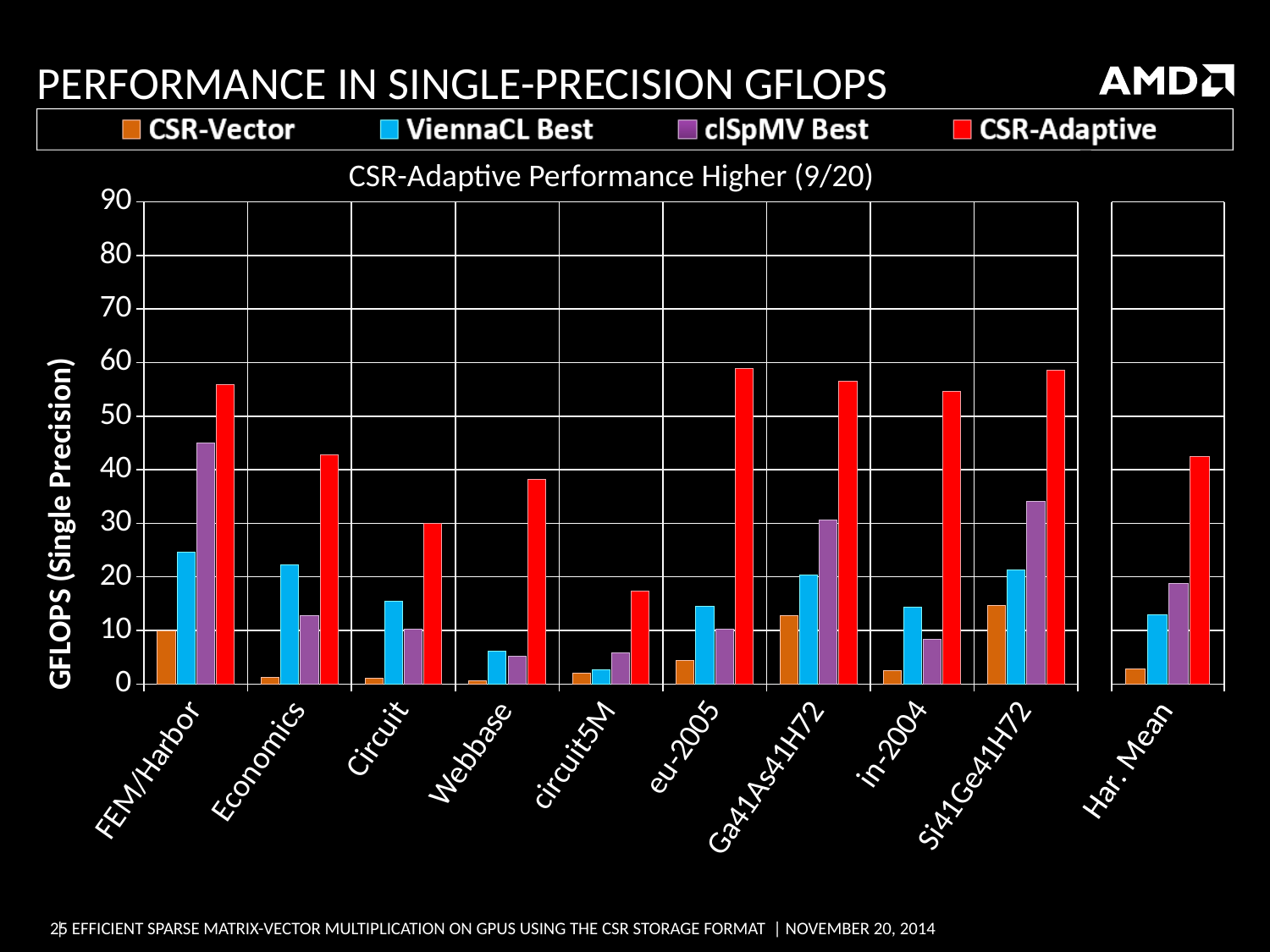
For FEM/Harbor, which is larger: the clSpMV Best value or the ViennaCL Best value? clSpMV Best Is the clSpMV Best value for Si41Ge41H72 greater or less than 30? greater How many categories are shown on the x axis, including Har. Mean? 10 What is the label of the y axis? GFLOPS (Single Precision) Is the CSR-Adaptive value for Har. Mean greater or less than 40? greater Is the CSR-Adaptive value for FEM/Harbor greater or less than 50? greater For Economics, which is larger: the ViennaCL Best value or the clSpMV Best value? ViennaCL Best For which category is the clSpMV Best value highest? FEM/Harbor What kind of chart is shown on the slide? bar chart For which category is the CSR-Adaptive value lowest? circuit5M How many series does the legend list? 4